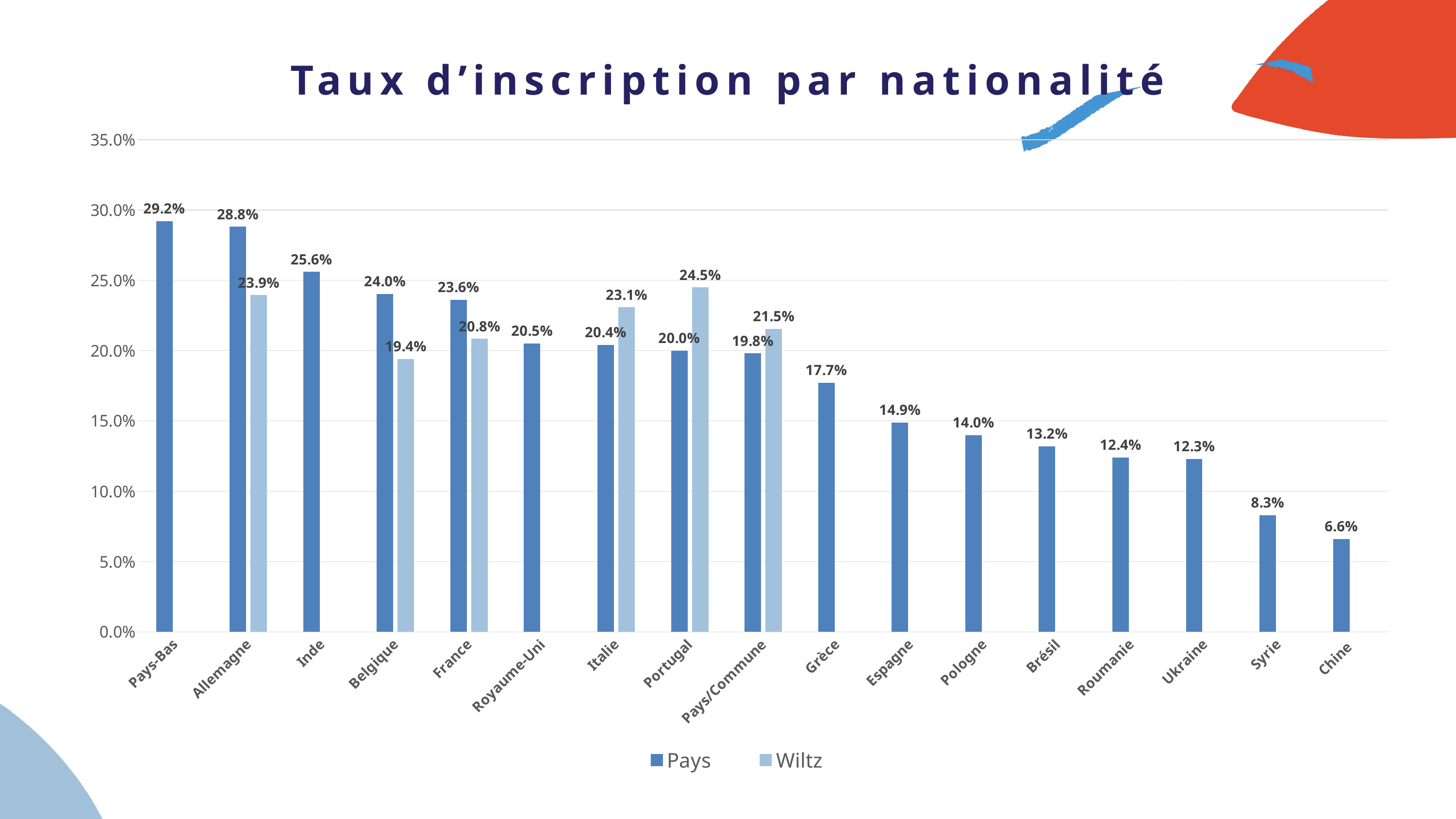
What kind of chart is shown on the slide? bar chart Which category has the highest Pays value? Pays-Bas What is the Pays value for Pays-Bas? 29.2% Is the Pays value for Grèce greater or less than 20.0%? less For Italie, which is larger: the Pays value or the Wiltz value? Wiltz What is the Wiltz value for Portugal? 24.5% How many series does the legend list? 2 What is the difference between the Pays and Wiltz values for Allemagne? 4.9% How many categories are shown on the x axis? 17 Which category has the lowest Pays value? Chine What is the Wiltz value for Belgique? 19.4% Which category has the highest Wiltz value? Portugal